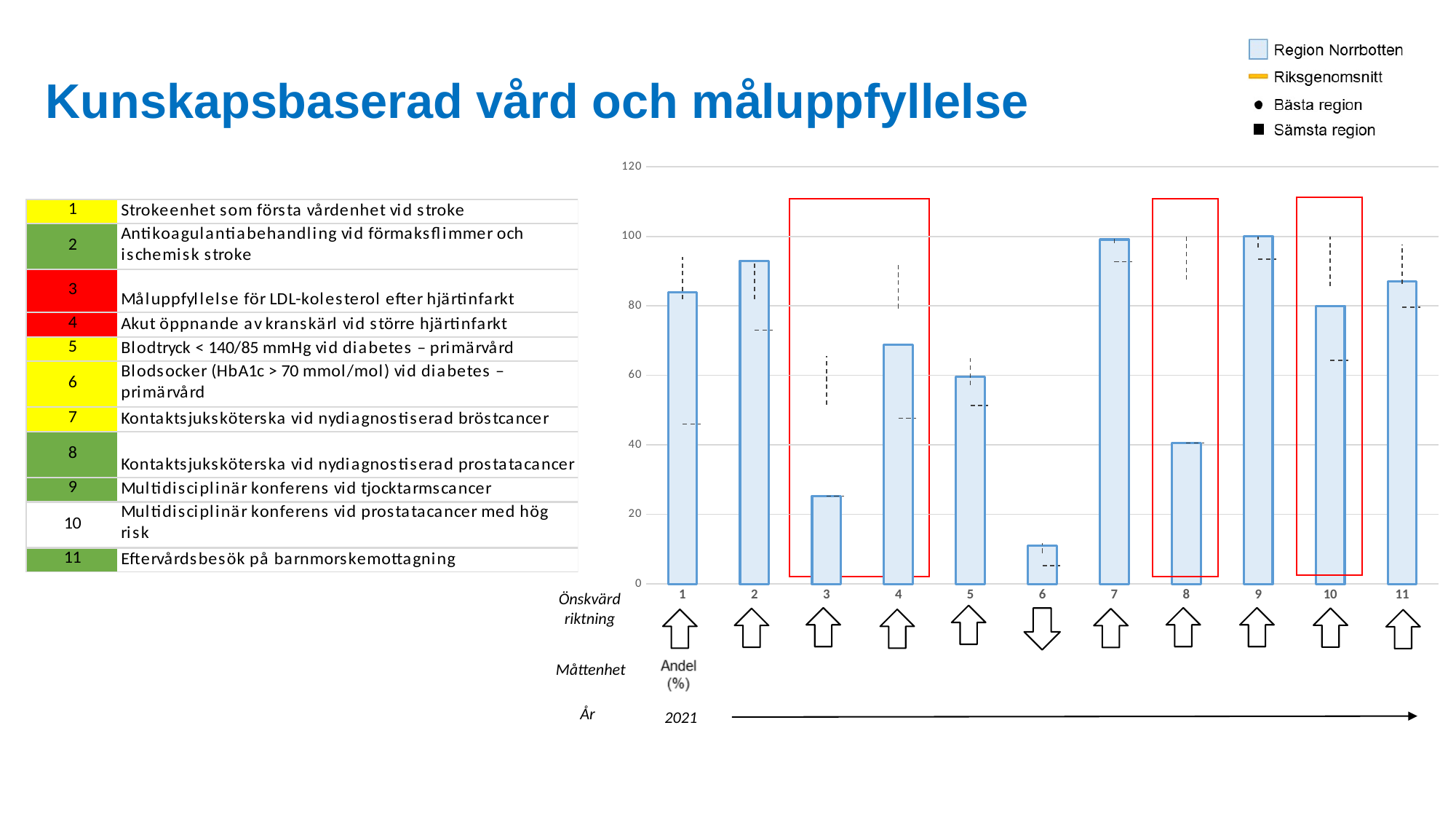
Is the value for category 4 greater or less than 60? greater Is the value for category 1 greater or less than 80? greater Is the value for category 6 greater or less than 20? less Which bar is taller, category 3 or category 4? 4 How many entries does the chart legend list? 4 Which legend entry is represented by the light blue bars? Region Norrbotten How many categories (bars) are plotted on the chart? 11 Which bar is taller, category 6 or category 8? 8 What kind of chart is shown on the slide? bar chart Which category has the lowest bar on the chart? 6